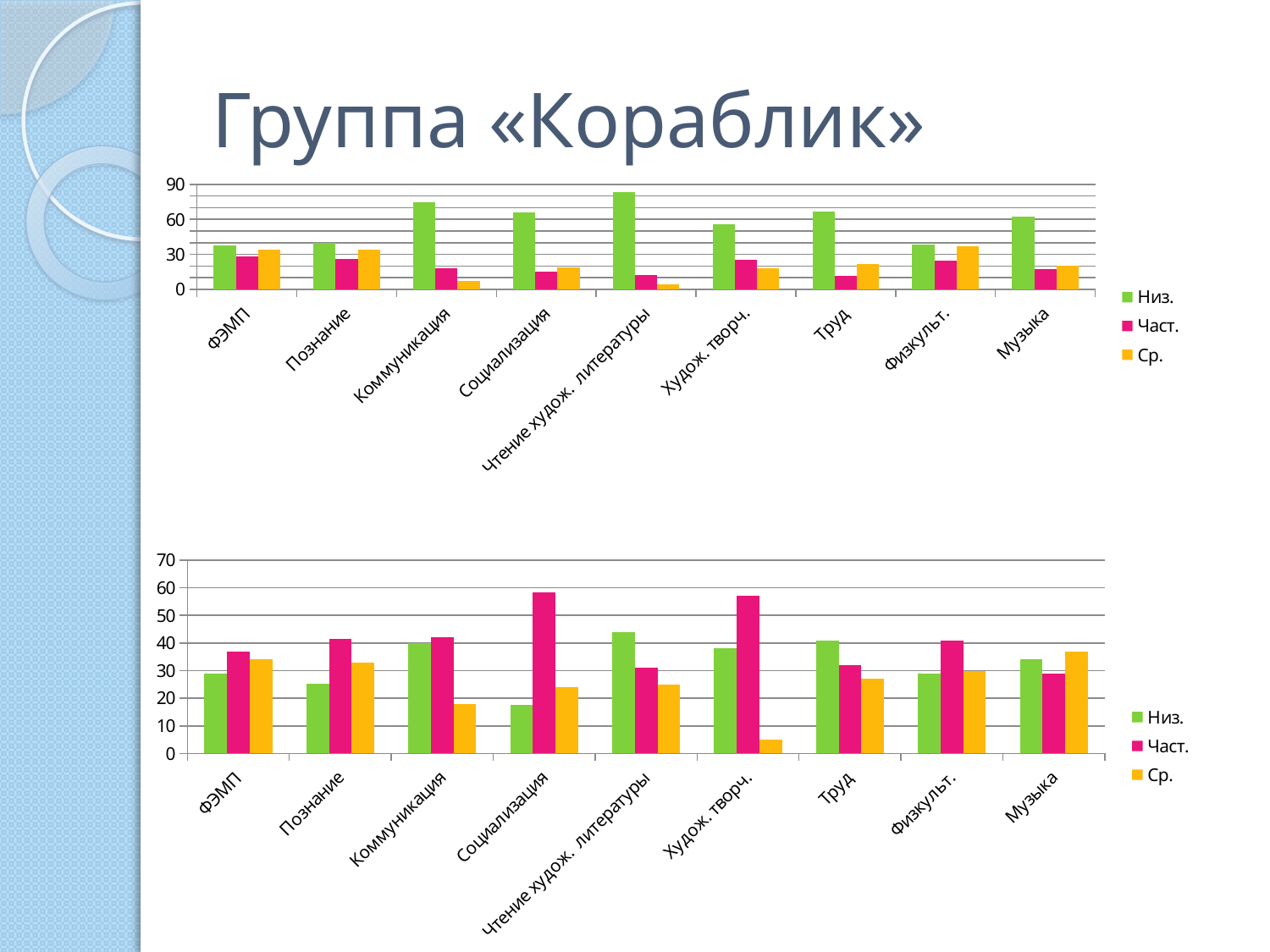
In the top chart, for Коммуникация, which is larger: the Низ. value or the Част. value? Низ. In the top chart, which category has the highest value for the Низ. series? Чтение худож. литературы In the top chart, is the Низ. value for Коммуникация greater or less than 60? greater In the bottom chart, is the Част. value for Социализация greater or less than 50? greater How many categories are shown on the x axis of the bottom chart? 9 In the bottom chart, which category has the lowest value for the Низ. series? Социализация What kind of chart is the top chart on the slide? bar chart In the bottom chart, which category has the lowest value for the Ср. series? Худож. творч. How many series does the legend of the top chart list? 3 In the bottom chart, for Музыка, which is larger: the Ср. value or the Част. value? Ср. What is the title of the slide containing the two charts? Группа «Кораблик» In the top chart, which category has the lowest value for the Ср. series? Чтение худож. литературы